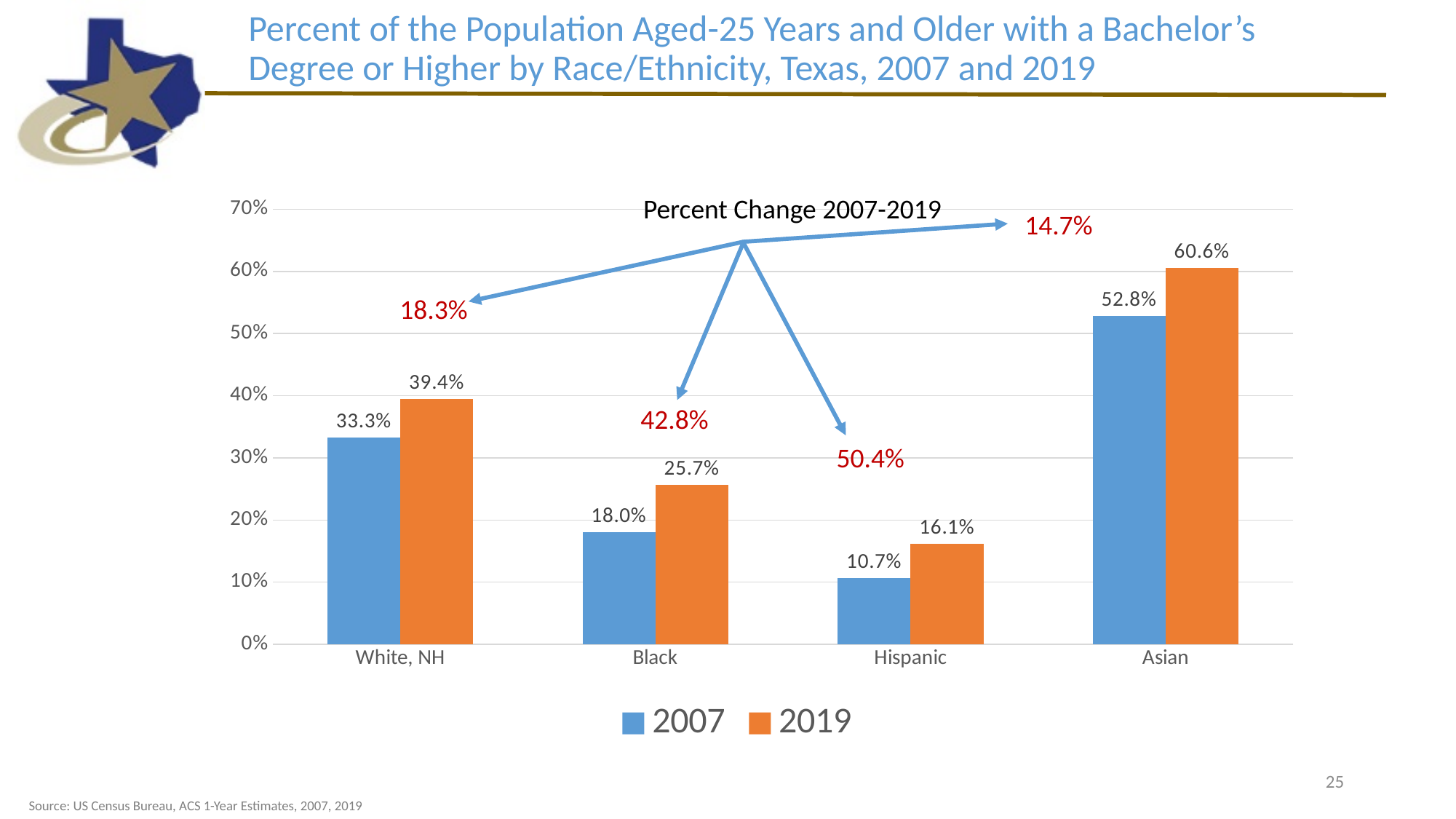
Which is larger: the 2007 value for White, NH or the 2019 value for Black? 2007 value for White, NH Which race/ethnicity group had the highest percentage in 2019? Asian What was the value for Hispanic in 2007? 10.7% What kind of chart is shown on the slide? Bar chart Is the 2007 value for Asian greater or less than 50%? greater What is the difference between the 2019 and 2007 values for Black? 7.7 percentage points What percent change from 2007 to 2019 is annotated for the Hispanic group? 50.4% How many race/ethnicity categories are shown on the x axis? 4 Which race/ethnicity group had the lowest percentage in 2007? Hispanic What was the percent of the White, NH population aged 25 and older with a bachelor's degree or higher in 2019? 39.4% What was the value for Asian in 2019? 60.6% How many series does the legend list? 2